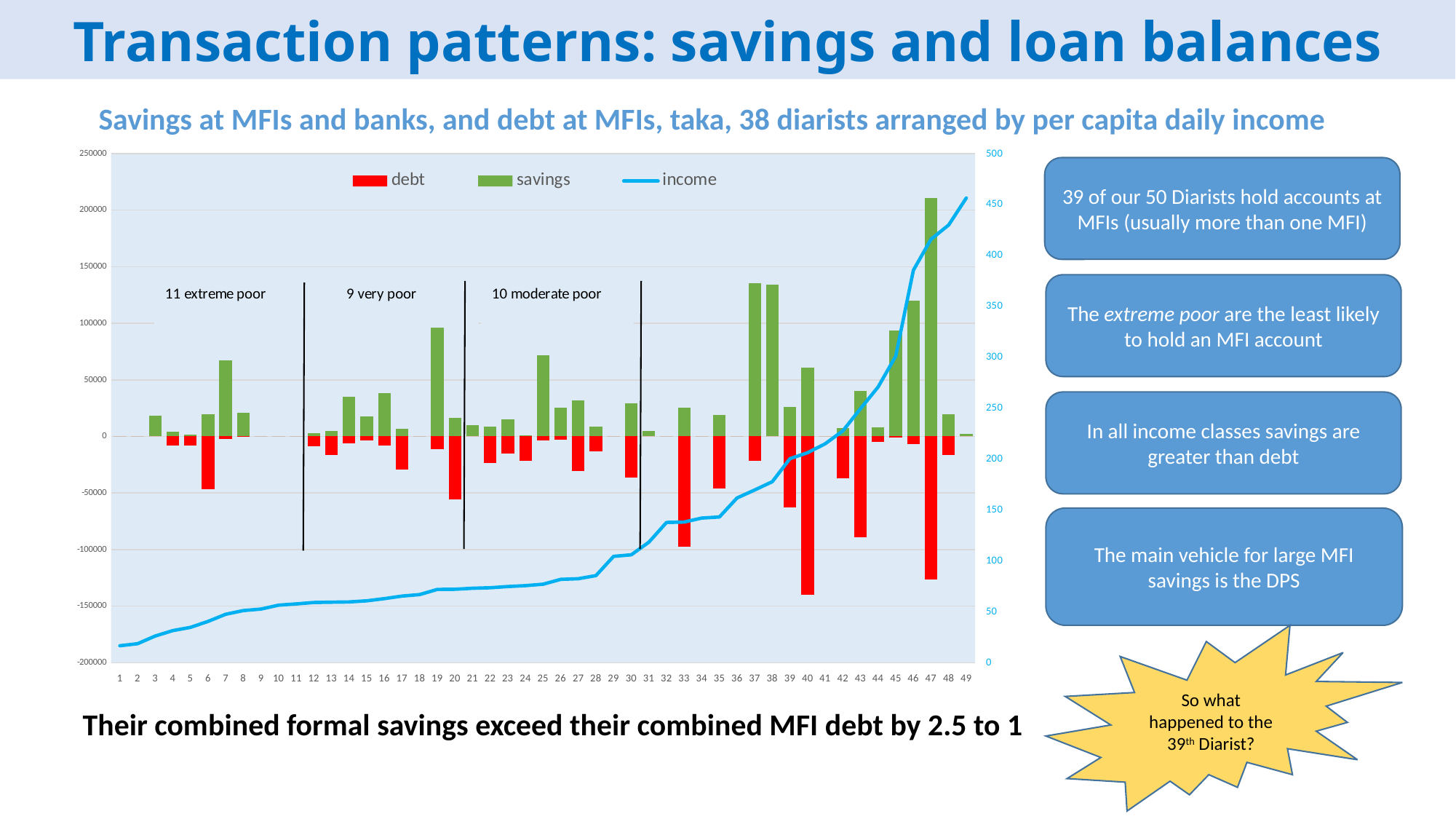
Which diarist number has the highest savings bar? 47 How many series does the chart legend list? 3 Which has the larger savings bar, diarist 19 or diarist 25? diarist 19 Does the income line rise or fall from diarist 1 to diarist 49? rises Is the income value for diarist 1 on the right axis greater or less than 50? less What are the three series named in the chart legend? debt, savings, income Is the savings value for diarist 37 greater or less than 100000? greater Is the income value for diarist 49 on the right axis greater or less than 400? greater What kind of chart is used to show debt and savings? bar chart Which diarist number has the largest debt (the longest red bar)? 40 What is the label of the first income group marked on the left of the chart? 11 extreme poor